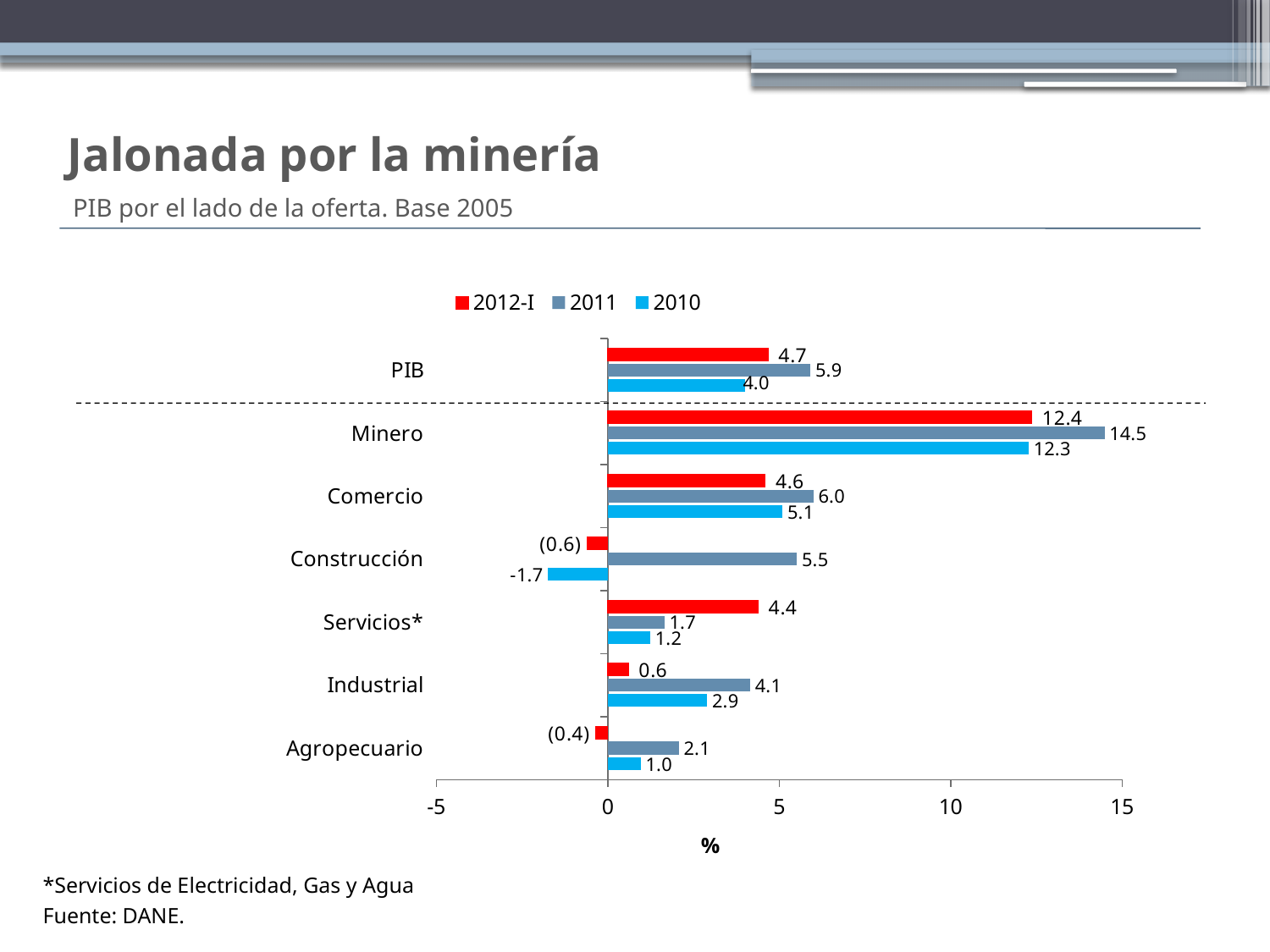
What is the value for Agropecuario in the 2012-I series? (0.4) How many categories are shown on the y axis? 7 What is the value for Construcción in the 2010 series? -1.7 What is the value for Minero in the 2011 series? 14.5 Which is larger for Servicios*: the 2012-I value or the 2011 value? 2012-I What is the difference between the 2011 and 2010 values for Comercio? 0.9 What kind of chart is shown on the slide? Bar chart Which category has the lowest value in the 2010 series? Construcción How many series does the legend list? 3 Which category has the highest value in the 2012-I series? Minero What is the value for PIB in the 2012-I series? 4.7 What is the subtitle of the chart on the slide? PIB por el lado de la oferta. Base 2005